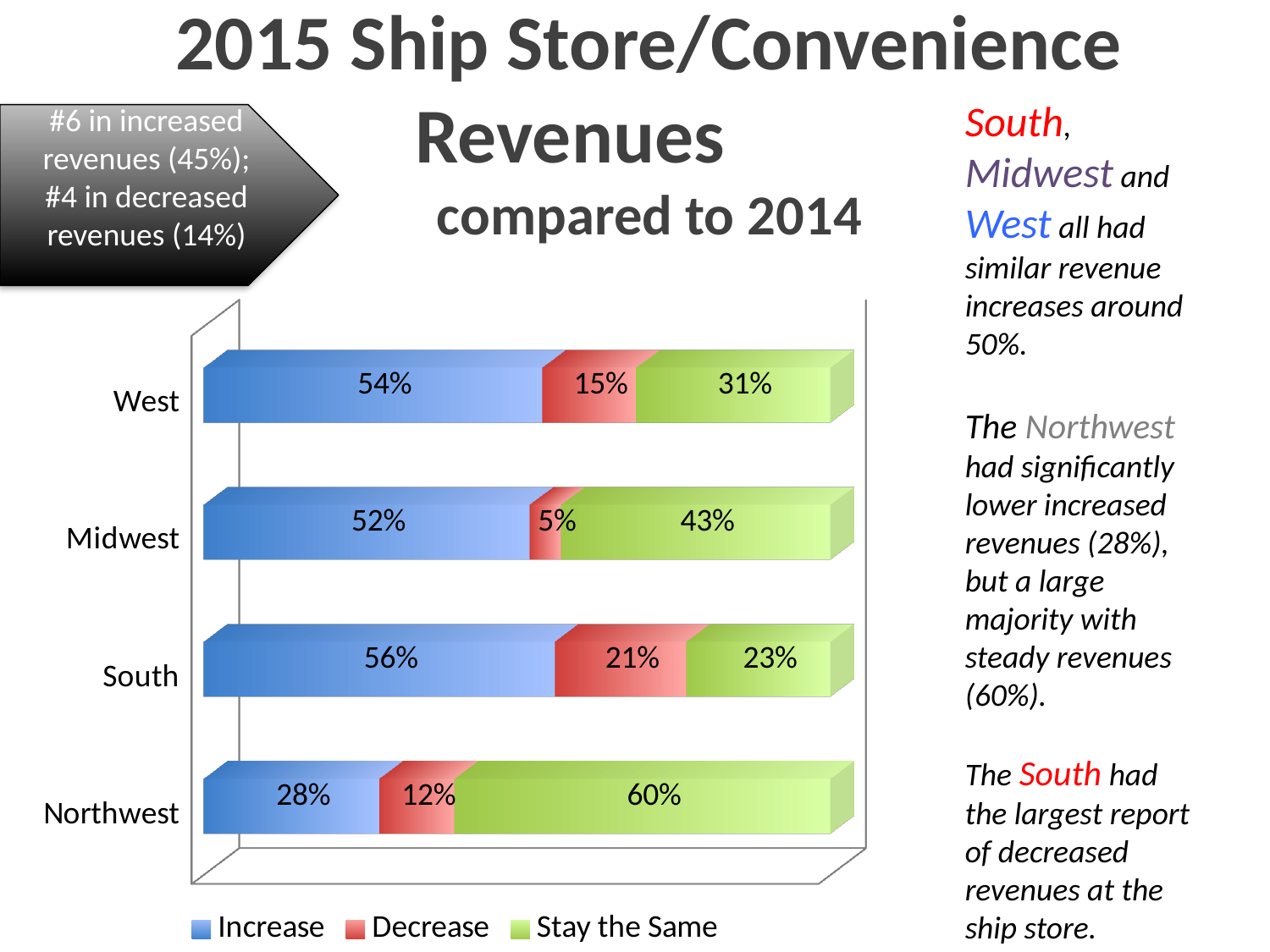
Which colour represents the Decrease series in the legend? Red Which region has the highest Increase percentage? South What percentage of the West reported an Increase in ship store revenues? 54% What is the total of the stacked bar for the South? 100% How many series does the legend list? 3 What is the Decrease value for the Midwest? 5% How many regions are shown on the chart? 4 Which is larger, the Stay the Same value for the Midwest or for the West? Midwest What percentage of the Northwest reported revenues that Stay the Same? 60% What kind of chart is shown on the slide? Stacked bar chart Which region has the lowest Decrease percentage? Midwest What is the difference between the South's Increase and the Northwest's Increase? 28%